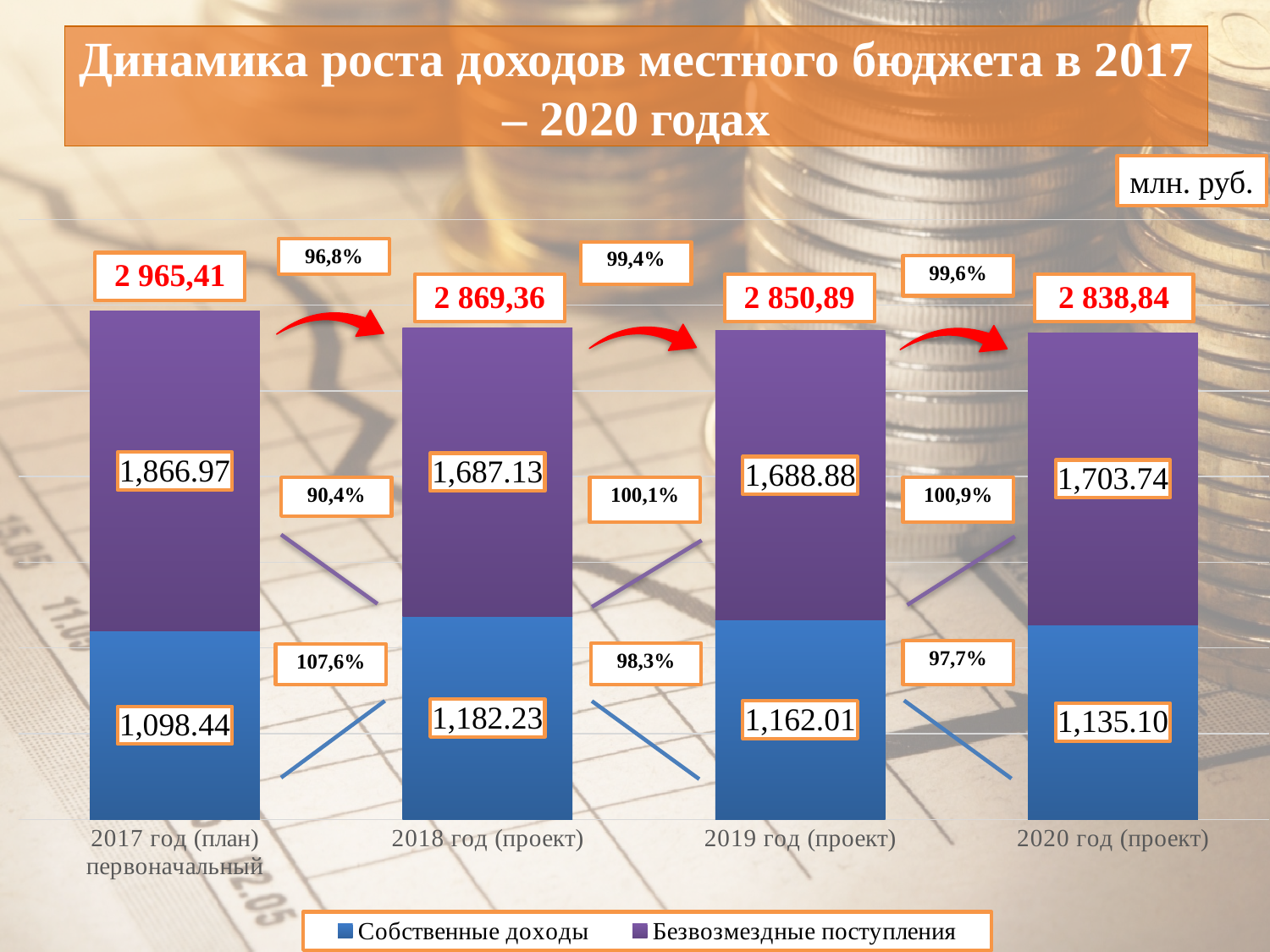
Which is larger: Безвозмездные поступления in 2019 год (проект) or in 2020 год (проект)? 2020 год (проект) How many series does the legend list? 2 What kind of chart is shown on the slide? Stacked bar chart What is the value of Безвозмездные поступления for 2017 год (план) первоначальный? 1,866.97 What is the difference between Собственные доходы in 2018 год (проект) and 2017 год (план) первоначальный? 83.79 Which year has the highest value for Собственные доходы? 2018 год (проект) What is the value of Безвозмездные поступления for 2020 год (проект)? 1,703.74 Do the total values printed above the bars rise or fall from 2017 to 2020? Fall How many years (categories) are shown on the x axis? 4 What is the total of the stacked bar for 2019 год (проект), as printed on the slide? 2 850,89 What is the value of Собственные доходы for 2018 год (проект)? 1,182.23 Which year has the lowest value for Безвозмездные поступления? 2018 год (проект)